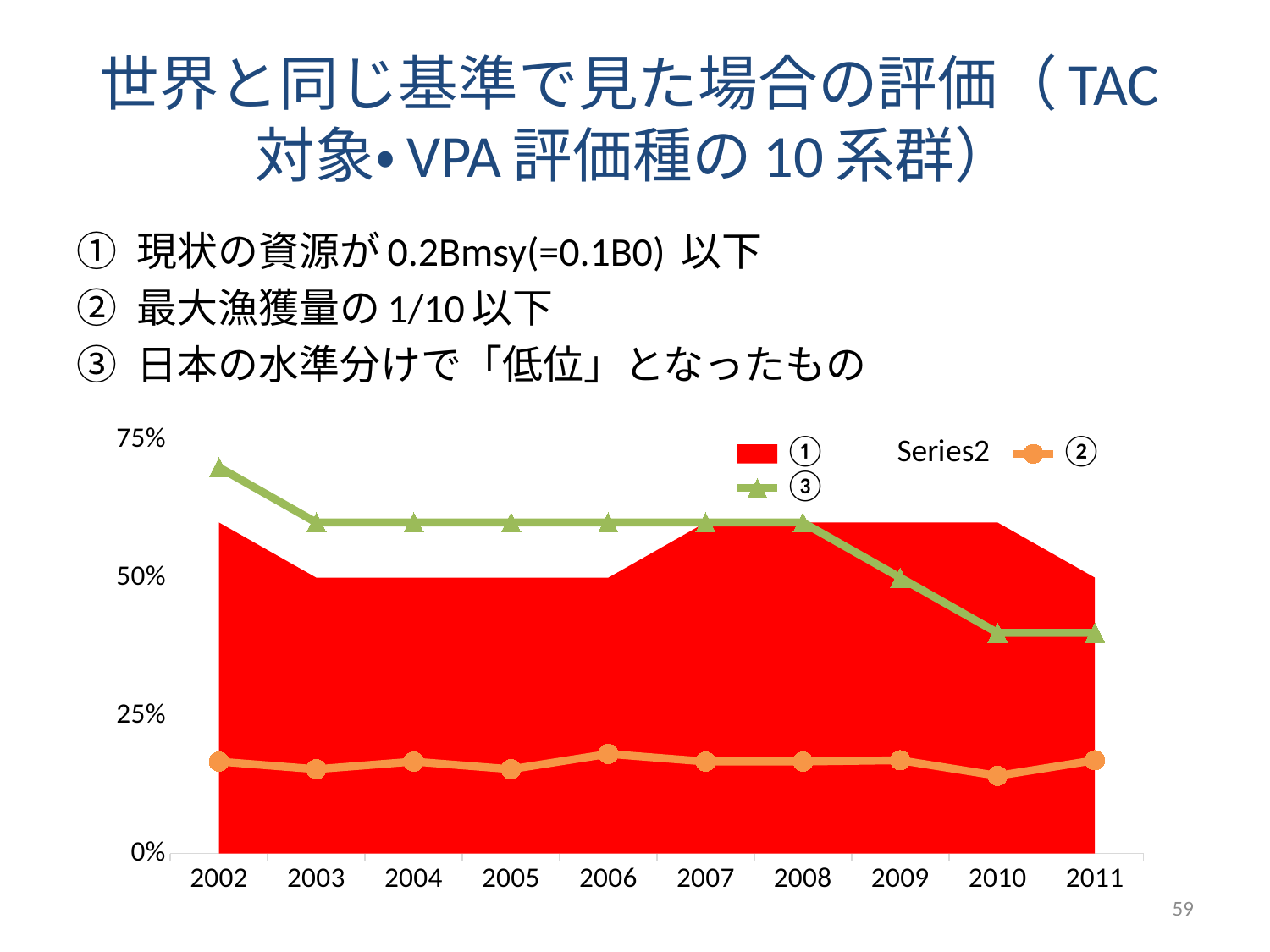
Is the value for series ③ in 2002 greater or less than 50%? greater What is the last year shown on the x axis of the chart? 2011 What kind of chart is series ③ drawn as? line chart Is the value for series ② in 2006 greater or less than 25%? less Does series ③ rise or fall from 2002 to 2011? fall In 2005, which is larger, series ② or series ③? series ③ What colour is the filled area for series ① in the chart? red How many series does the chart's legend list? 4 Is the value for series ③ in 2011 greater or less than 50%? less In which year is series ③ at its highest? 2002 What is the first year shown on the x axis of the chart? 2002 How many years are shown on the x axis of the chart? 10